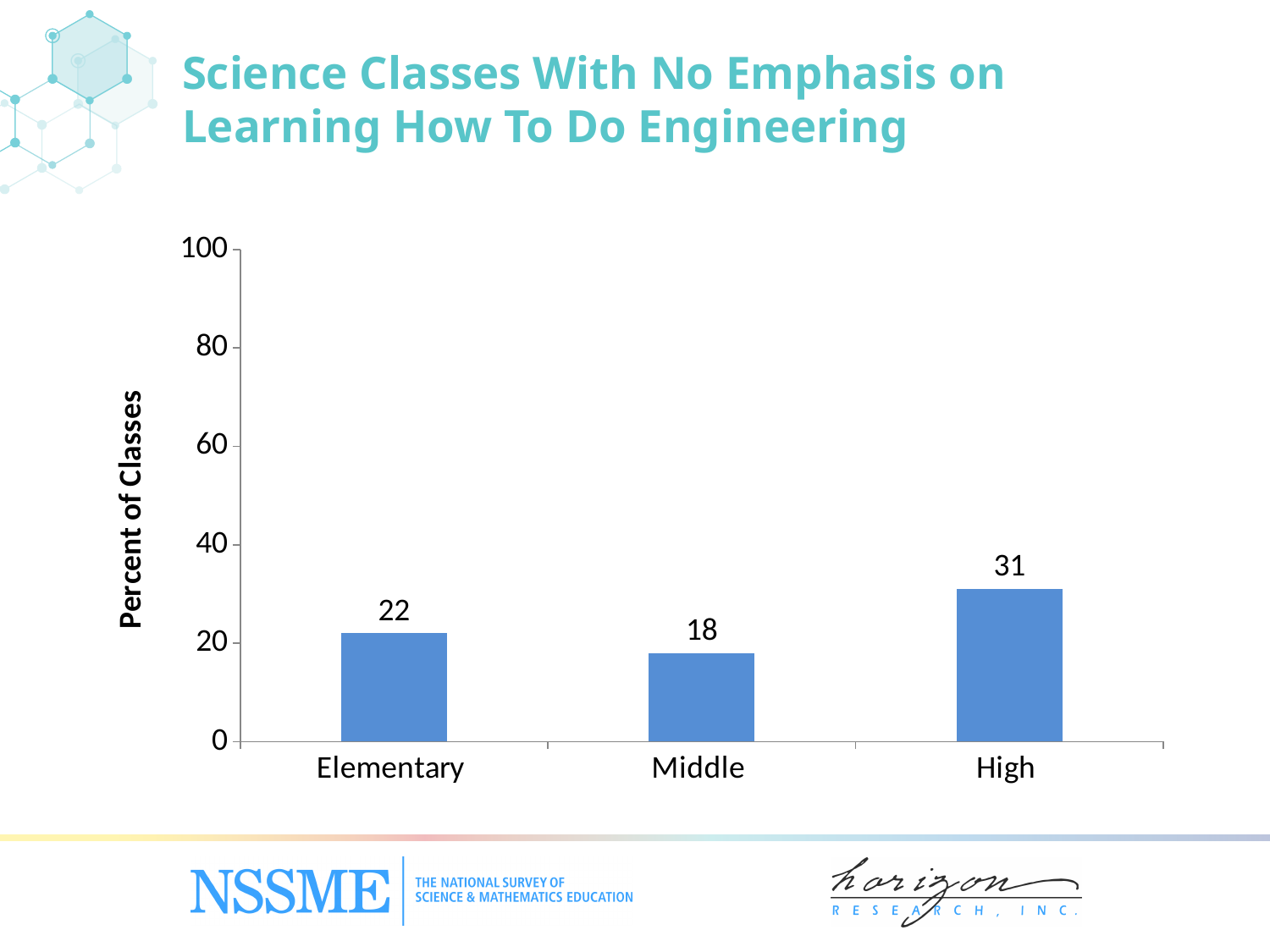
How many categories are shown on the x axis? 3 What kind of chart is shown on the slide? bar chart What is the value for High? 31 What is the difference between the values for Elementary and Middle? 4 Which category has the lowest value? Middle Which category has the highest value? High What is the value for Elementary? 22 What is the value for Middle? 18 What is the label of the y axis? Percent of Classes Is the value for High greater or less than 40? less What is the difference between the values for High and Middle? 13 Which is larger, the value for Elementary or the value for High? High